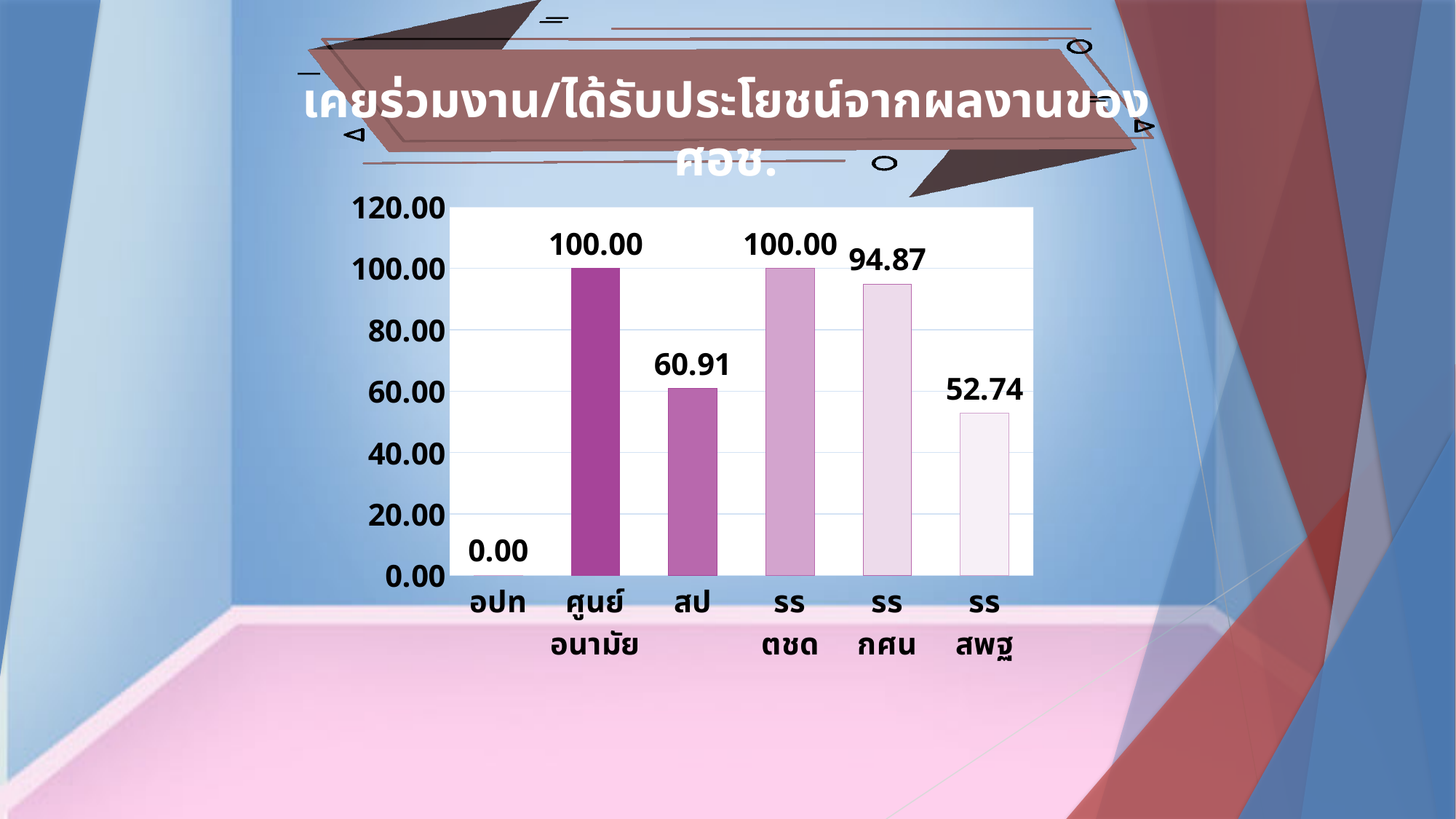
What is the difference between the values for ศูนย์อนามัย and สป? 39.09 What is the value for อปท? 0.00 What is the value for ศูนย์อนามัย? 100.00 What is the value for สป? 60.91 What is the difference between the values for รร กศน and รร สพฐ? 42.13 How many categories are shown on the x axis? 6 What is the value for รร กศน? 94.87 Which category has the lowest value? อปท What is the value for รร สพฐ? 52.74 What kind of chart is shown on the slide? bar chart Which is larger, the value for สป or the value for รร สพฐ? สป Is the value for รร กศน greater or less than 80.00? greater